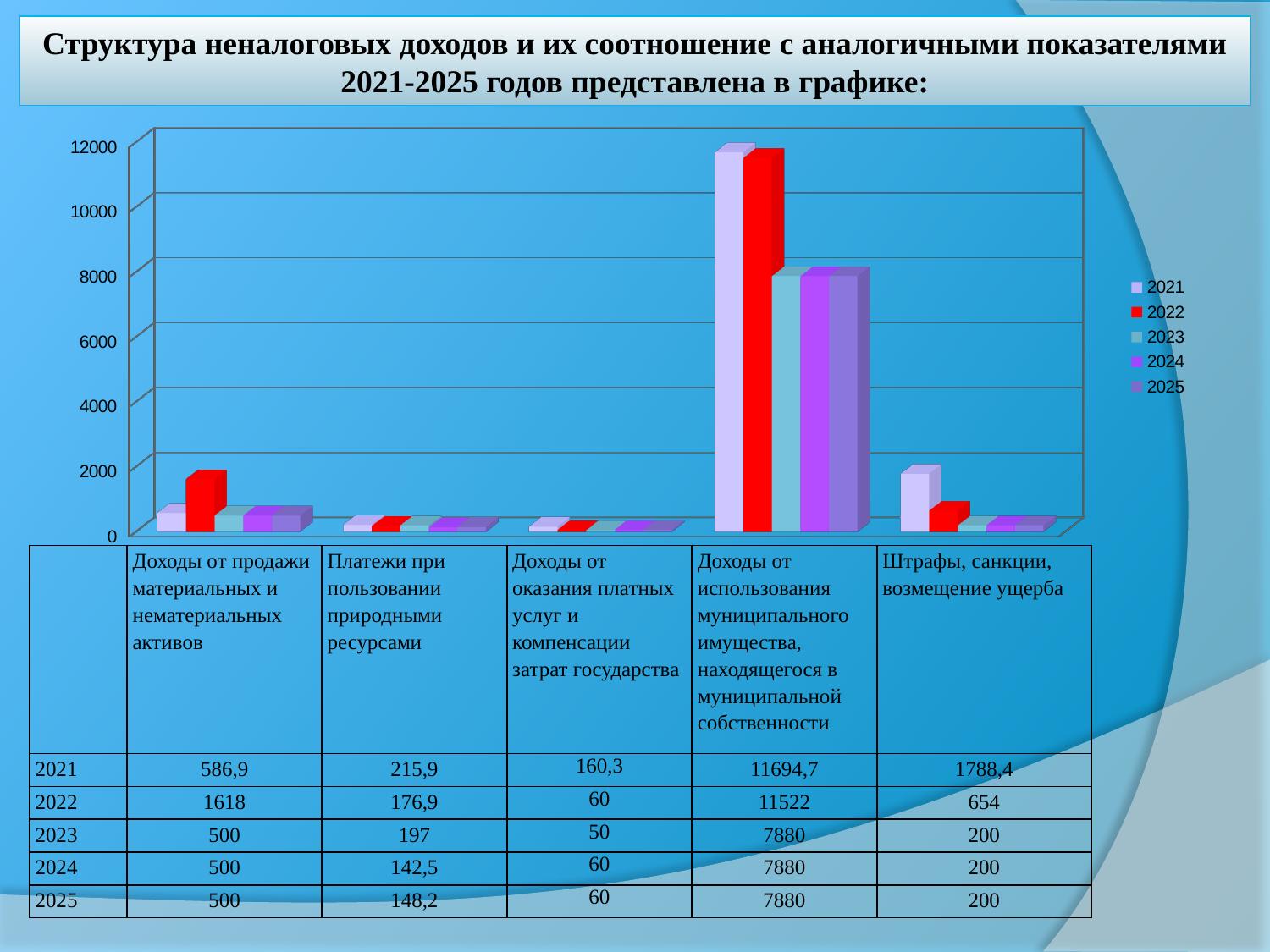
What kind of chart is shown on the slide? bar chart What is the value for 2022 in the category "Доходы от продажи материальных и нематериальных активов"? 1618 What is the value for 2024 in the category "Платежи при пользовании природными ресурсами"? 142,5 Which is larger for "Штрафы, санкции, возмещение ущерба": the 2021 value or the 2022 value? 2021 What is the difference between the 2021 and 2022 values for "Доходы от использования муниципального имущества, находящегося в муниципальной собственности"? 172,7 Which category has the highest value for the 2022 series? Доходы от использования муниципального имущества, находящегося в муниципальной собственности Is the 2023 value for "Доходы от использования муниципального имущества, находящегося в муниципальной собственности" greater or less than 6000? greater How many series does the legend list? 5 What is the value for 2021 in the category "Штрафы, санкции, возмещение ущерба"? 1788,4 Which category has the lowest value for the 2023 series? Доходы от оказания платных услуг и компенсации затрат государства How many categories are shown on the x axis of the chart? 5 What is the value for 2021 in the category "Доходы от использования муниципального имущества, находящегося в муниципальной собственности"? 11694,7